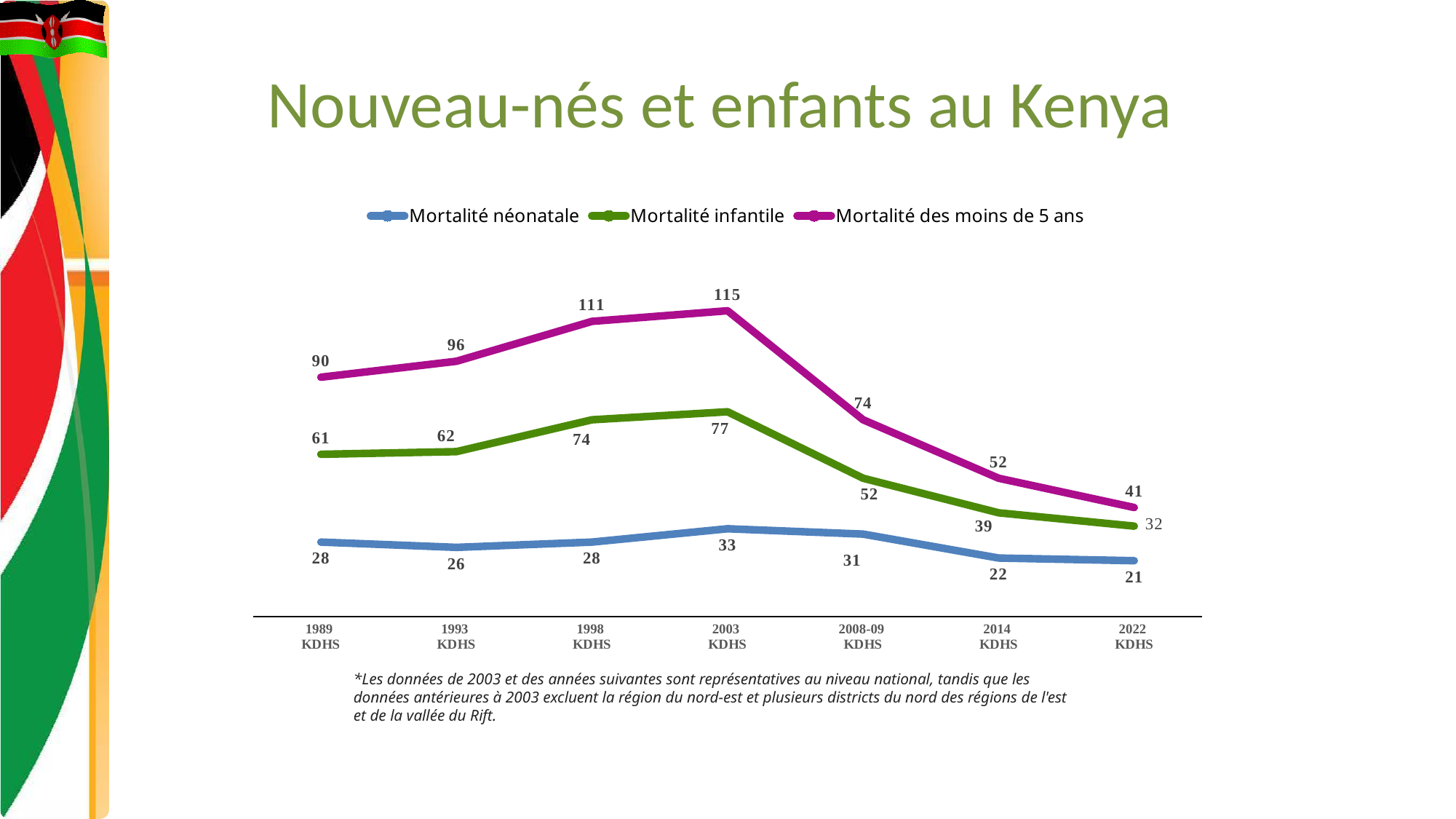
What is the value of Mortalité infantile for 1998 KDHS? 74 What is the title of the slide? Nouveau-nés et enfants au Kenya How many series does the legend list? 3 What kind of chart is shown on the slide? Line chart Which is larger: Mortalité infantile in 1989 KDHS or Mortalité infantile in 2014 KDHS? 1989 KDHS What is the value of Mortalité des moins de 5 ans for 2003 KDHS? 115 How many survey years are shown on the x axis? 7 What is the value of Mortalité néonatale for 2022 KDHS? 21 In which survey year does Mortalité des moins de 5 ans reach its highest value? 2003 KDHS In which survey year is Mortalité néonatale lowest? 2022 KDHS Does Mortalité des moins de 5 ans rise or fall from 2003 KDHS to 2022 KDHS? Fall What is the difference between Mortalité des moins de 5 ans and Mortalité infantile in 2008-09 KDHS? 22